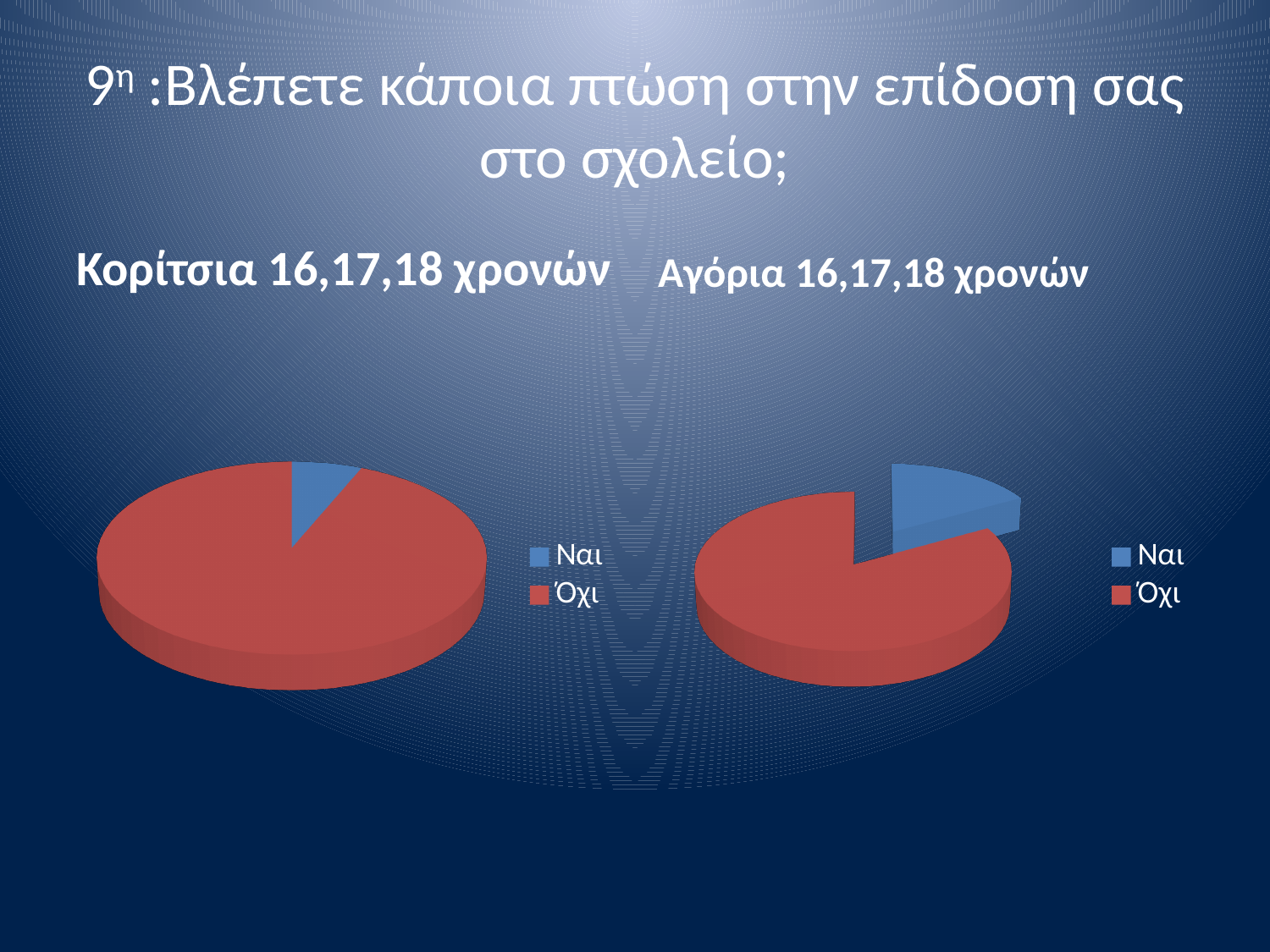
What kind of chart is used for "Αγόρια 16,17,18 χρονών"? pie chart In the "Κορίτσια 16,17,18 χρονών" chart, which category has the largest slice? Όχι In the "Κορίτσια 16,17,18 χρονών" chart, which category has the smallest slice? Ναι In the "Αγόρια 16,17,18 χρονών" chart, which category has the smallest slice? Ναι How many slices does the "Κορίτσια 16,17,18 χρονών" pie chart have? 2 In the "Κορίτσια 16,17,18 χρονών" chart, what colour is the "Όχι" slice? red Which chart has the larger "Ναι" slice, "Κορίτσια 16,17,18 χρονών" or "Αγόρια 16,17,18 χρονών"? Αγόρια 16,17,18 χρονών How many slices does the "Αγόρια 16,17,18 χρονών" pie chart have? 2 How many entries does the legend of the "Αγόρια 16,17,18 χρονών" chart list? 2 What kind of chart is used for "Κορίτσια 16,17,18 χρονών"? pie chart In the "Αγόρια 16,17,18 χρονών" chart, which category has the largest slice? Όχι What are the two legend entries of the "Αγόρια 16,17,18 χρονών" chart? Ναι, Όχι